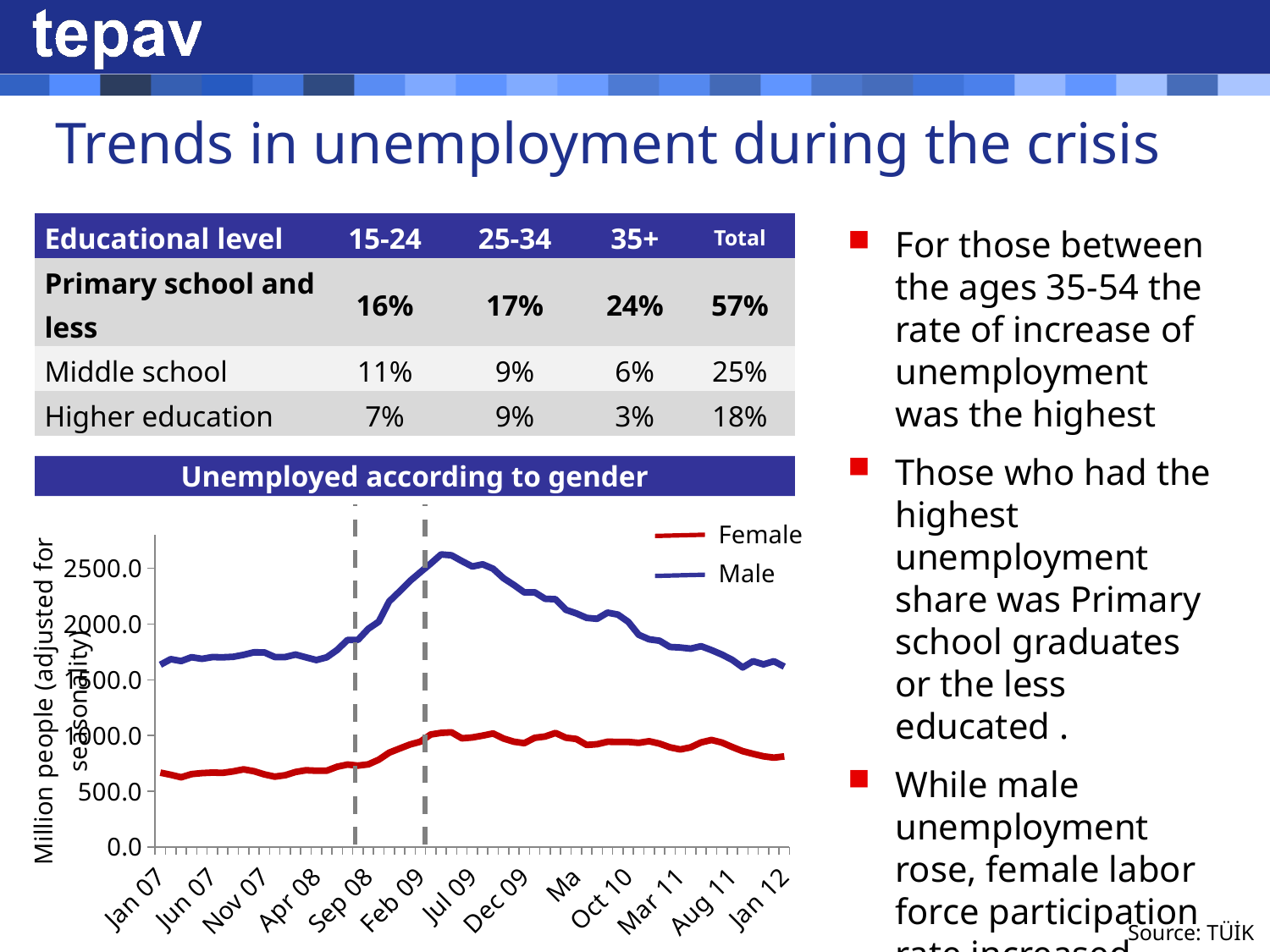
In the 'Unemployed according to gender' chart, is the Female value at Jan 07 greater or less than 1000.0? less What is the y-axis label of the 'Unemployed according to gender' chart? Million people (adjusted for seasonality) In the 'Unemployed according to gender' chart, does the Male series rise or fall between Jul 09 and Jan 12? fall What kind of chart is shown under the title 'Unemployed according to gender'? line chart What colour is the Male line in the 'Unemployed according to gender' chart? blue In the 'Unemployed according to gender' chart, is the Female value at Jan 07 greater or less than 500.0? greater In the 'Unemployed according to gender' chart, which series has higher values throughout the period, Male or Female? Male In the 'Unemployed according to gender' chart, is the Female value at Jan 12 greater or less than 1000.0? less In the 'Unemployed according to gender' chart, does the Male series rise or fall between Sep 08 and Jul 09? rise How many series does the legend of the 'Unemployed according to gender' chart list? 2